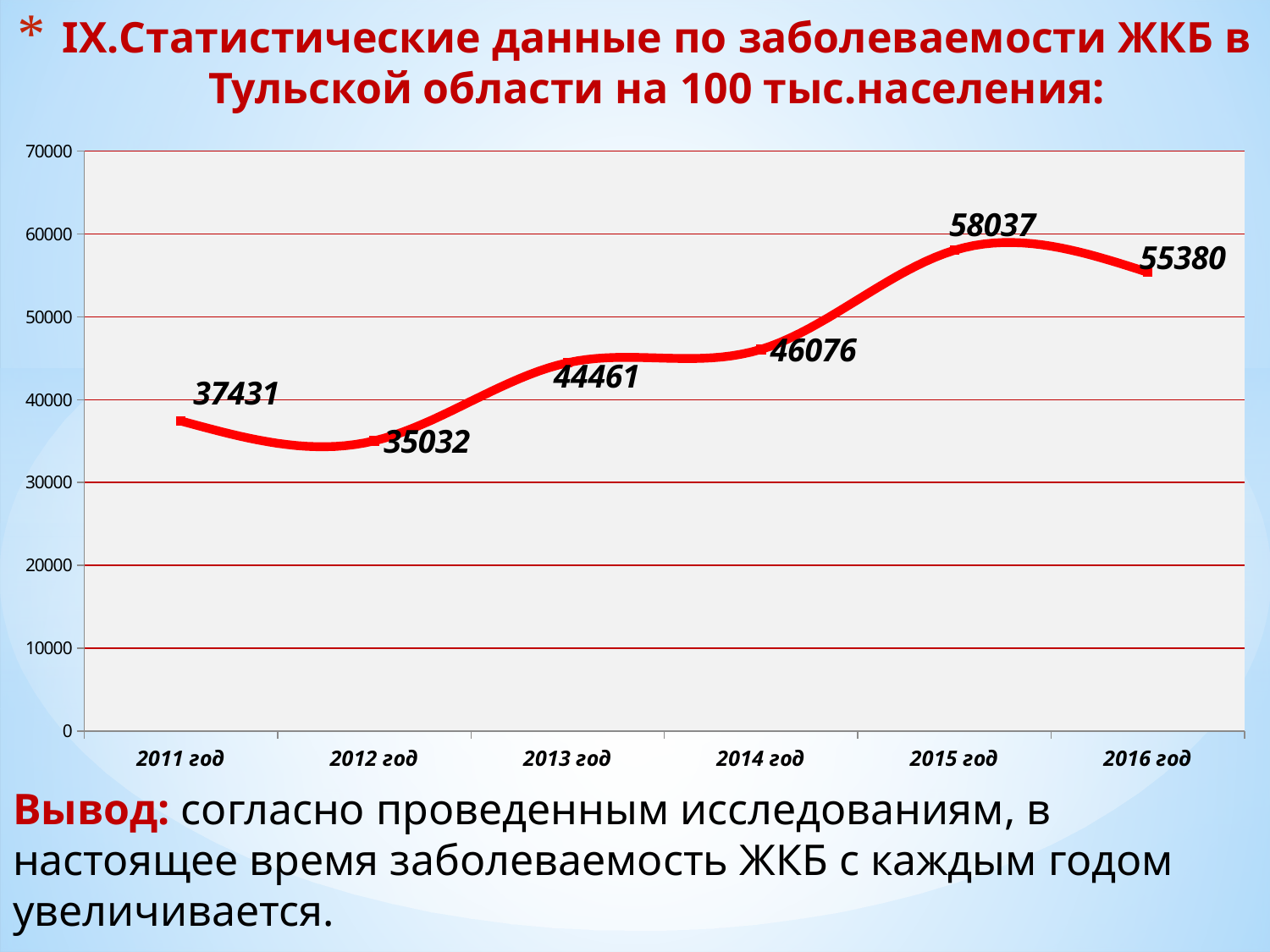
Is the value for 2015 год greater or less than 50000? greater Which year has the highest value? 2015 год What is the value for 2011 год? 37431 What is the value for 2016 год? 55380 Which year has the lowest value? 2012 год How many years are plotted on the chart? 6 What kind of chart is shown on the slide? line chart What is the difference between the values for 2012 год and 2011 год? 2399 What is the difference between the values for 2015 год and 2016 год? 2657 Does the value rise or fall from 2012 год to 2015 год? rise Which is larger, the value for 2014 год or the value for 2013 год? 2014 год What is the value for 2013 год? 44461